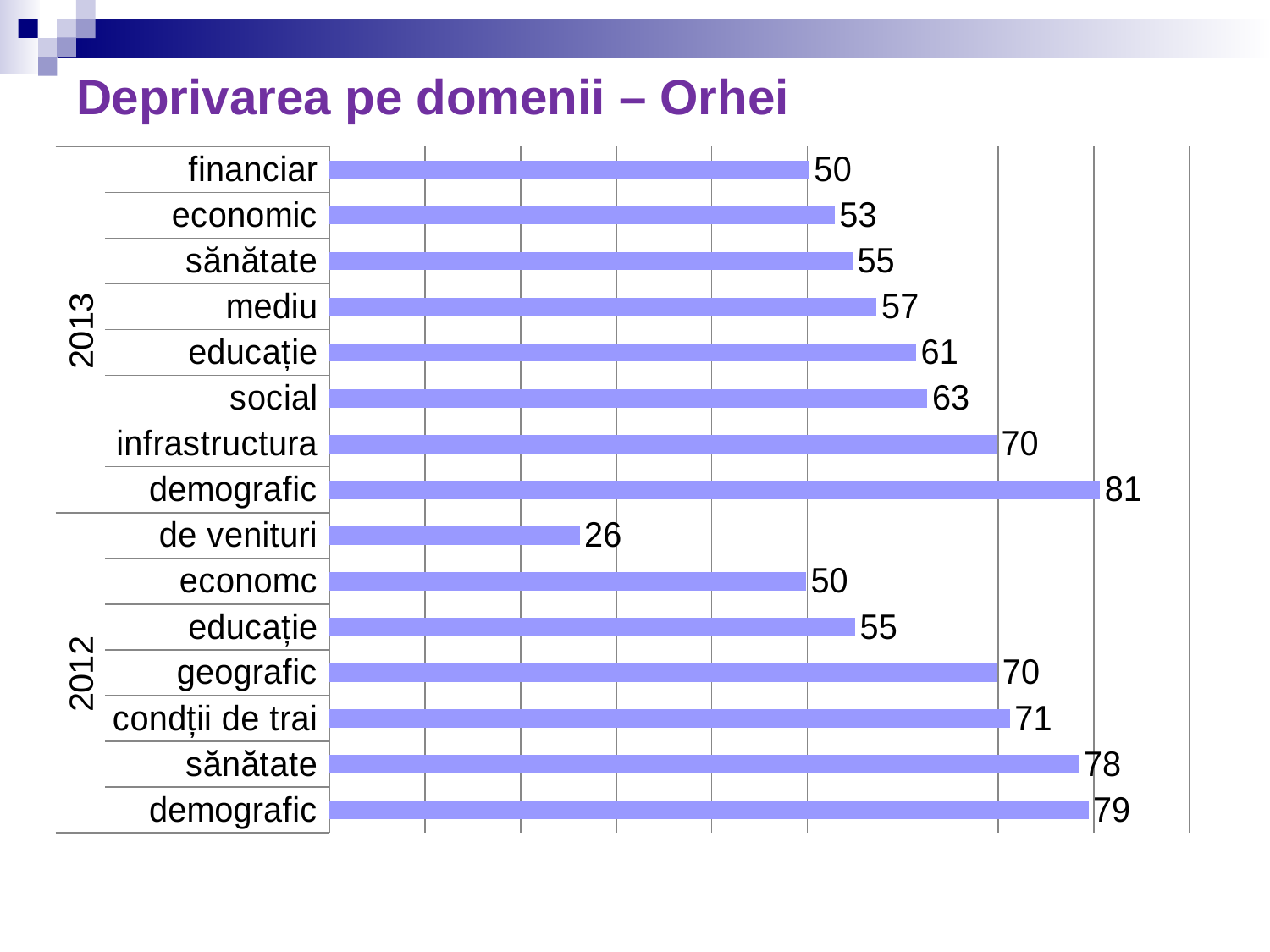
What is the difference between demografic in 2013 and demografic in 2012? 2 Which category has the highest value in the 2013 group? demografic What is the value for infrastructura in 2013? 70 How many bars are plotted in the chart in total? 15 What is the value for demografic in 2013? 81 Which category has the lowest value in the 2012 group? de venituri What is the difference between sănătate in 2012 and sănătate in 2013? 23 What is the value for sănătate in 2012? 78 What is the value for de venituri in 2012? 26 Which is larger: educație in 2013 or educație in 2012? educație in 2013 What kind of chart is shown on the slide? bar chart What is the title of the chart? Deprivarea pe domenii – Orhei